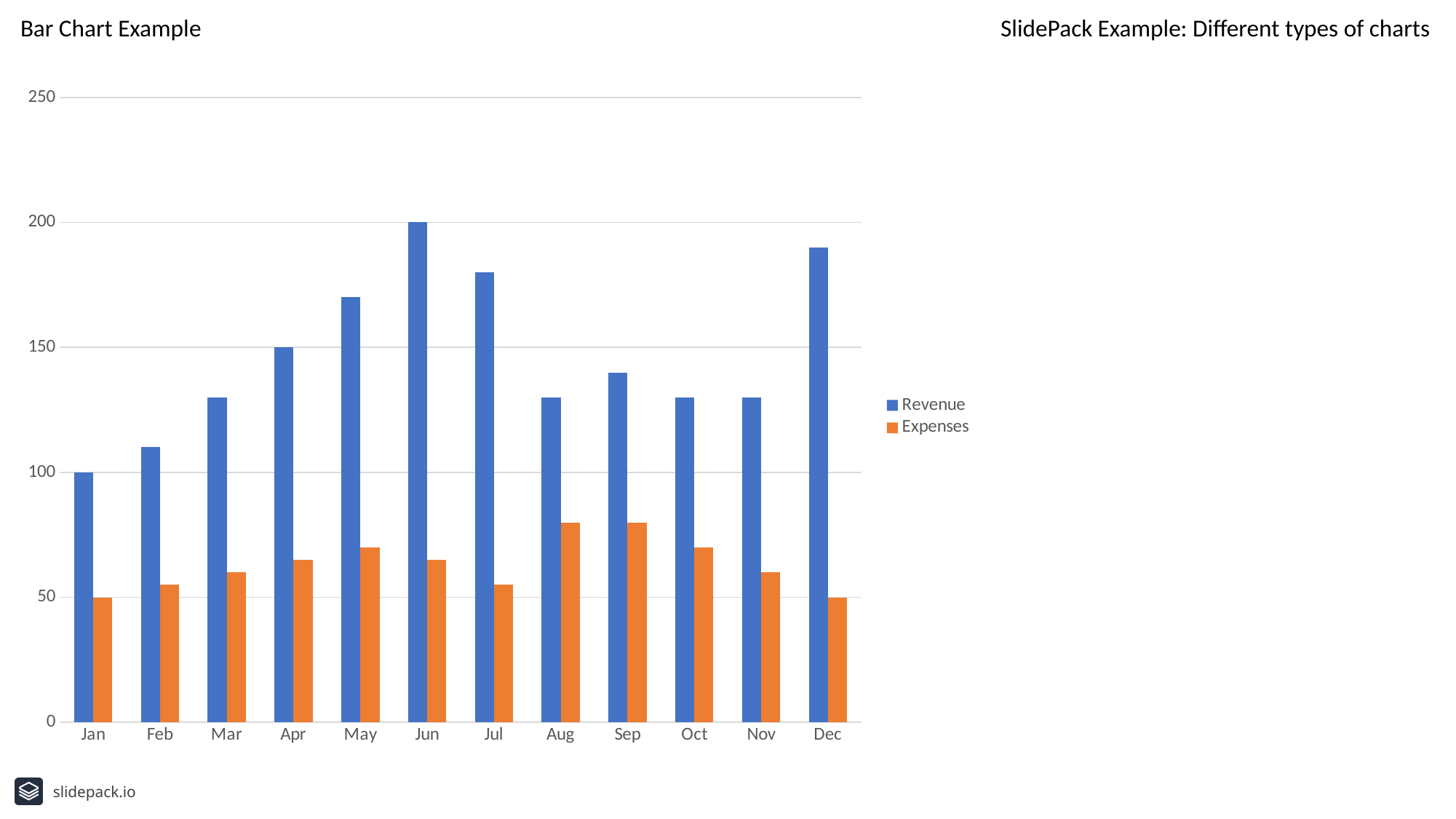
Is the Expenses value for Aug greater or less than 50? greater Does Revenue rise or fall from Jan to Jun? Rises What is the Revenue value for Jan? 100 What is the Expenses value for Jan? 50 What is the difference between the Revenue for Jun and the Revenue for Jan? 100 How many series does the legend list? 2 Is the Revenue value for Jul greater or less than 150? greater Which month has the highest Revenue? Jun What is the Revenue value for Jun? 200 What type of chart is shown on the slide? Bar chart How many months are shown on the x axis? 12 Which month has the lowest Revenue? Jan